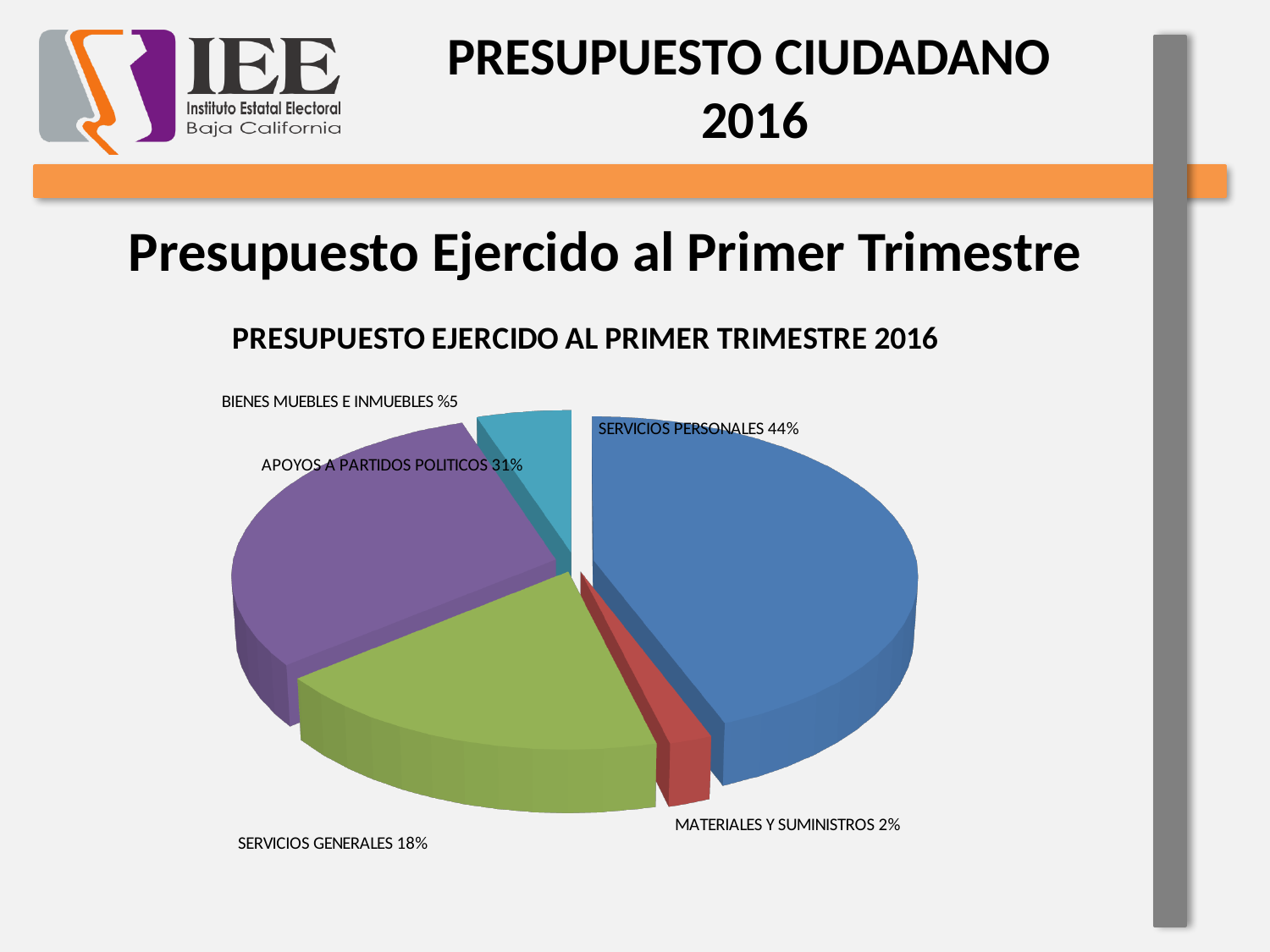
What value is labelled for BIENES MUEBLES E INMUEBLES? %5 How many categories are shown in the pie chart? 5 Which is larger, SERVICIOS GENERALES or APOYOS A PARTIDOS POLITICOS? APOYOS A PARTIDOS POLITICOS What kind of chart is shown on the slide? pie chart Which category has the smallest slice of the pie? MATERIALES Y SUMINISTROS What share of the pie does MATERIALES Y SUMINISTROS represent? 2% What share of the pie does SERVICIOS GENERALES represent? 18% What share of the pie does SERVICIOS PERSONALES represent? 44% What is the difference in percentage points between SERVICIOS PERSONALES and APOYOS A PARTIDOS POLITICOS? 13 Which category has the largest slice of the pie? SERVICIOS PERSONALES What is the title of the chart? PRESUPUESTO EJERCIDO AL PRIMER TRIMESTRE 2016